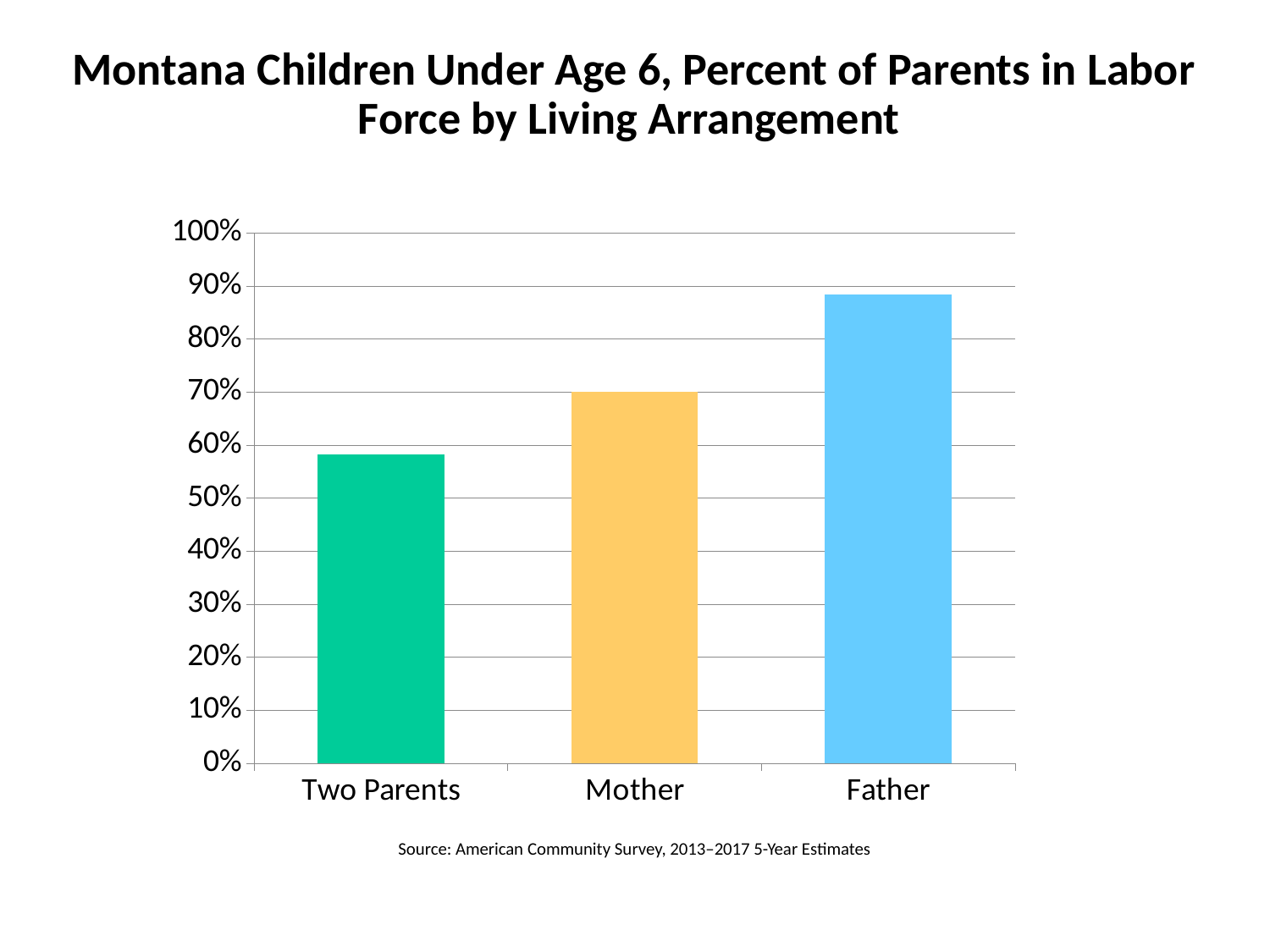
What colour is the bar for Father? light blue Which living arrangement has the highest percent of parents in the labor force? Father How many living arrangement categories are shown on the x axis? 3 Which is larger, the value for Mother or the value for Two Parents? Mother Which living arrangement has the lowest percent of parents in the labor force? Two Parents Is the value for Two Parents greater or less than 50%? greater Is the value for Father greater or less than 90%? less Is the value for Father greater or less than 80%? greater What kind of chart is shown on the slide? bar chart Do the values rise or fall moving from Two Parents to Father along the x axis? rise What is the title of the chart? Montana Children Under Age 6, Percent of Parents in Labor Force by Living Arrangement